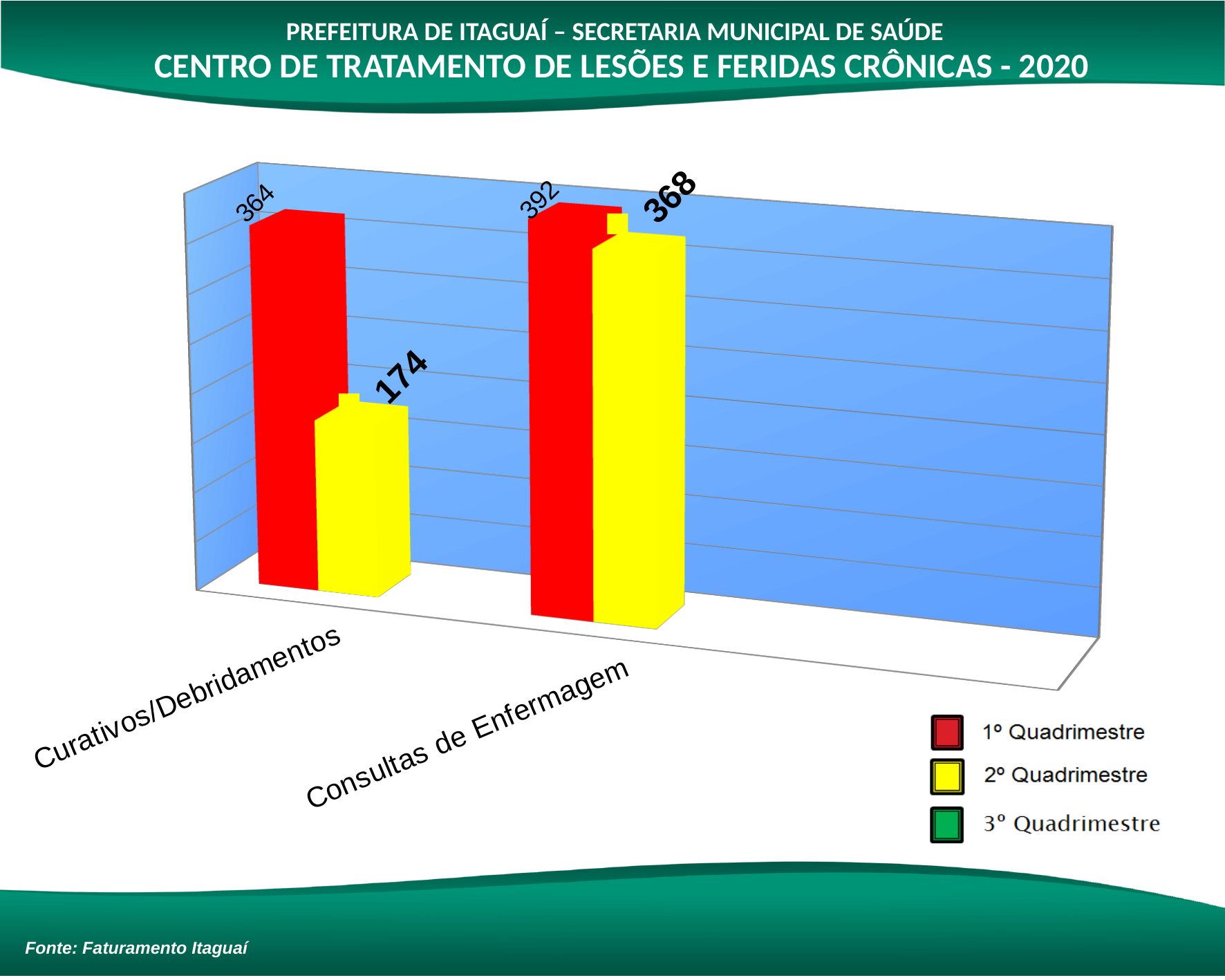
How many series does the legend list? 3 What is the difference between the 1º Quadrimestre and 2º Quadrimestre values for Consultas de Enfermagem? 24 How many categories are shown on the x axis? 2 Which category has the lowest value in the 2º Quadrimestre? Curativos/Debridamentos What is the value for Curativos/Debridamentos in the 1º Quadrimestre? 364 Which is larger for Consultas de Enfermagem: the 1º Quadrimestre or the 2º Quadrimestre value? 1º Quadrimestre Which category has the highest value in the 1º Quadrimestre? Consultas de Enfermagem What is the value for Curativos/Debridamentos in the 2º Quadrimestre? 174 What is the value for Consultas de Enfermagem in the 1º Quadrimestre? 392 What is the value for Consultas de Enfermagem in the 2º Quadrimestre? 368 What is the difference between the 1º Quadrimestre and 2º Quadrimestre values for Curativos/Debridamentos? 190 What kind of chart is shown on the slide? Bar chart